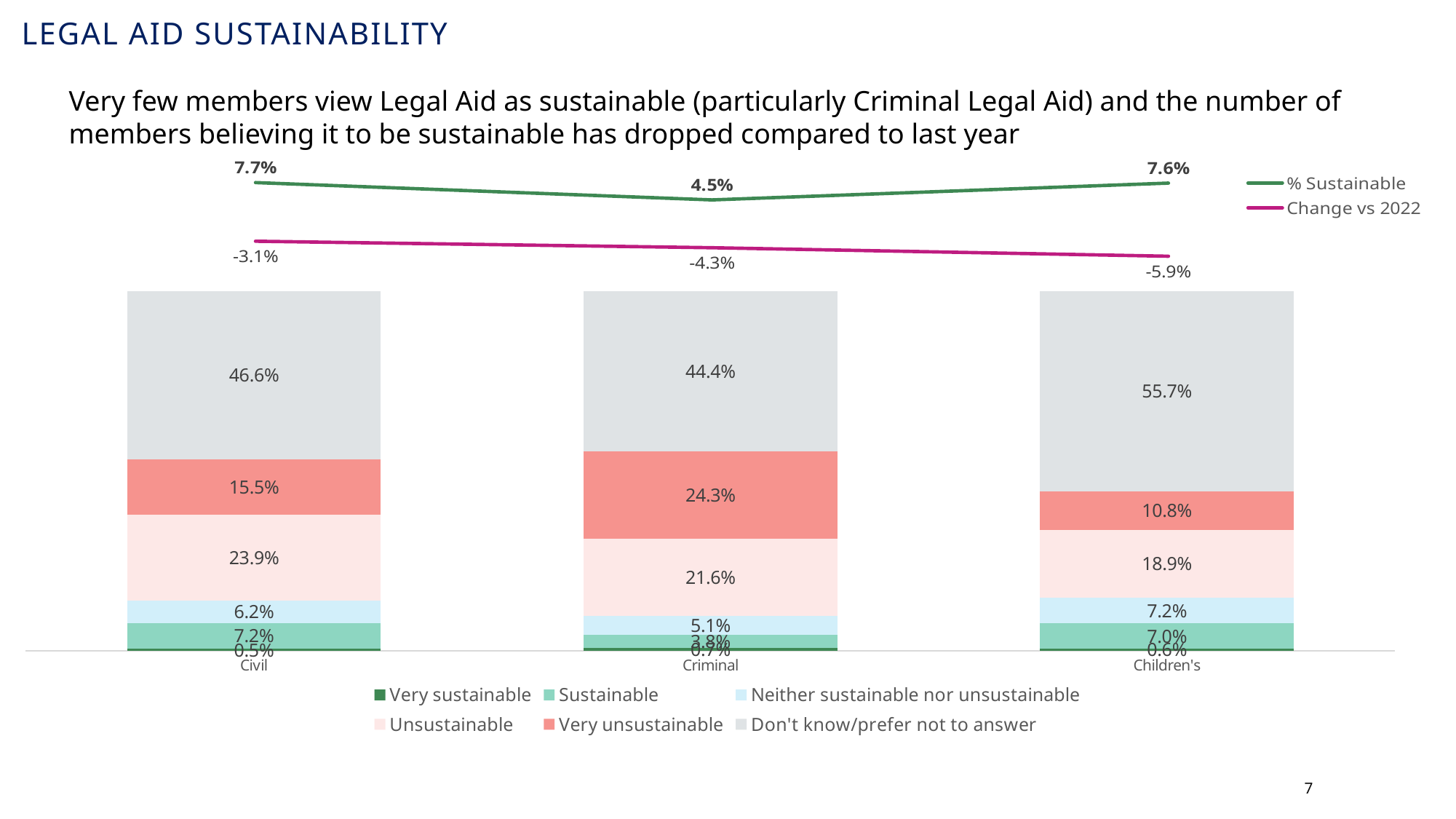
How many categories are shown on the x axis of the chart? 3 Does the 'Change vs 2022' line rise or fall from Civil to Children's? Falls What kind of chart is used to show the sustainability responses by category? Stacked bar chart What is the 'Change vs 2022' value for Children's? -5.9% Which has the larger 'Very unsustainable' value, Civil or Children's? Civil How many series does the legend below the stacked bars list? 6 Which category has the lowest '% Sustainable' value? Criminal What is the difference between the 'Unsustainable' values for Civil and Children's? 5.0% Which category has the highest 'Don't know/prefer not to answer' share? Children's What is the '% Sustainable' value shown for Criminal? 4.5% What is the 'Very unsustainable' value for Criminal Legal Aid? 24.3% What percentage of members answered 'Don't know/prefer not to answer' for Children's Legal Aid? 55.7%